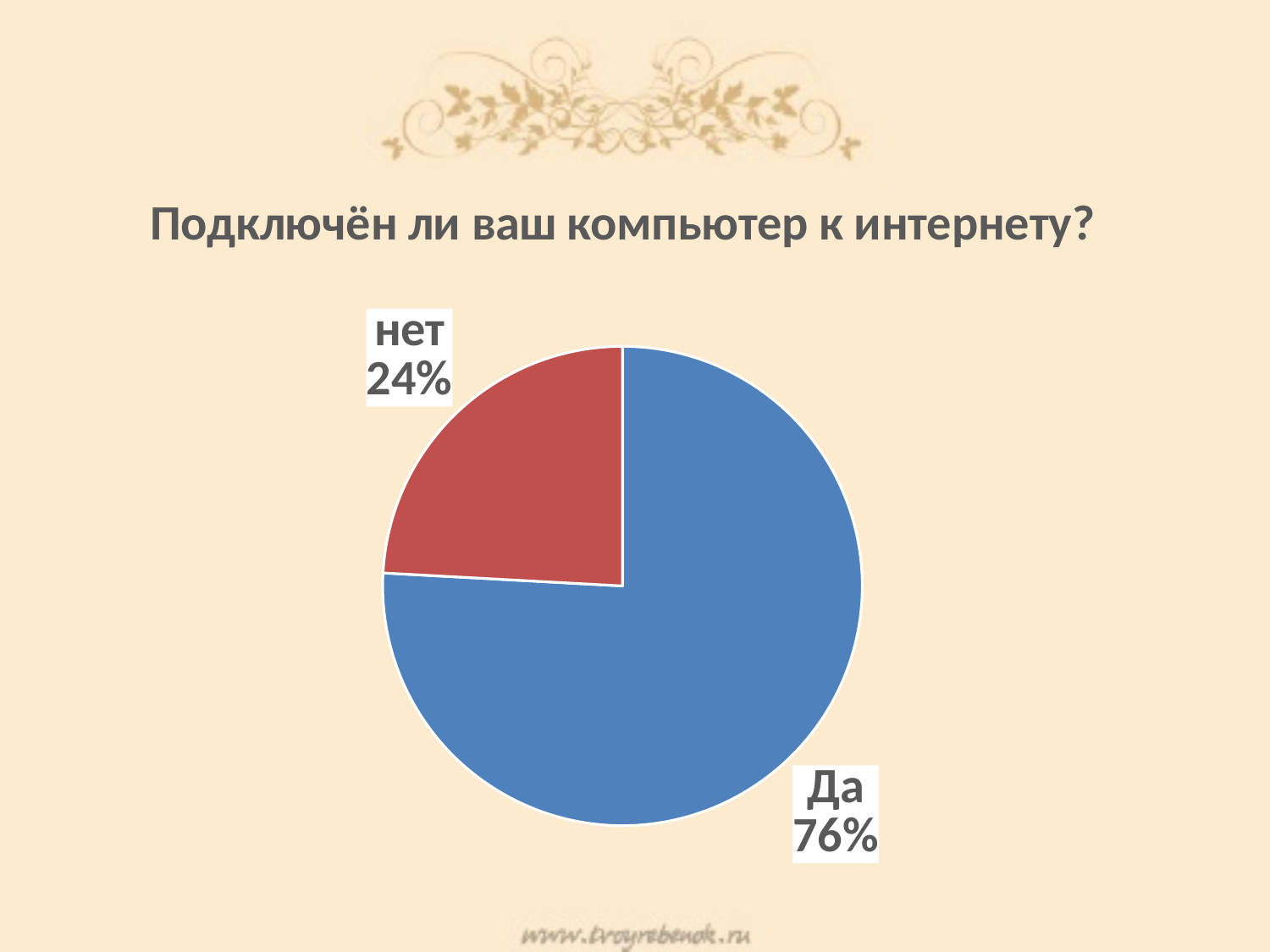
What is the difference in percentage points between the "Да" and "нет" slices? 52 What percentage of the pie is labelled "Да"? 76% What kind of chart is shown on the slide? Pie chart What colour is the "Да" slice of the pie? Blue How many slices does the pie chart have? 2 Which slice of the pie is the smallest? нет What share of the pie does the "нет" slice represent? 24% Which slice is larger, "Да" or "нет"? Да What is the title of the chart on the slide? Подключён ли ваш компьютер к интернету? What percentage of the pie is labelled "нет"? 24% Which slice of the pie is the largest? Да